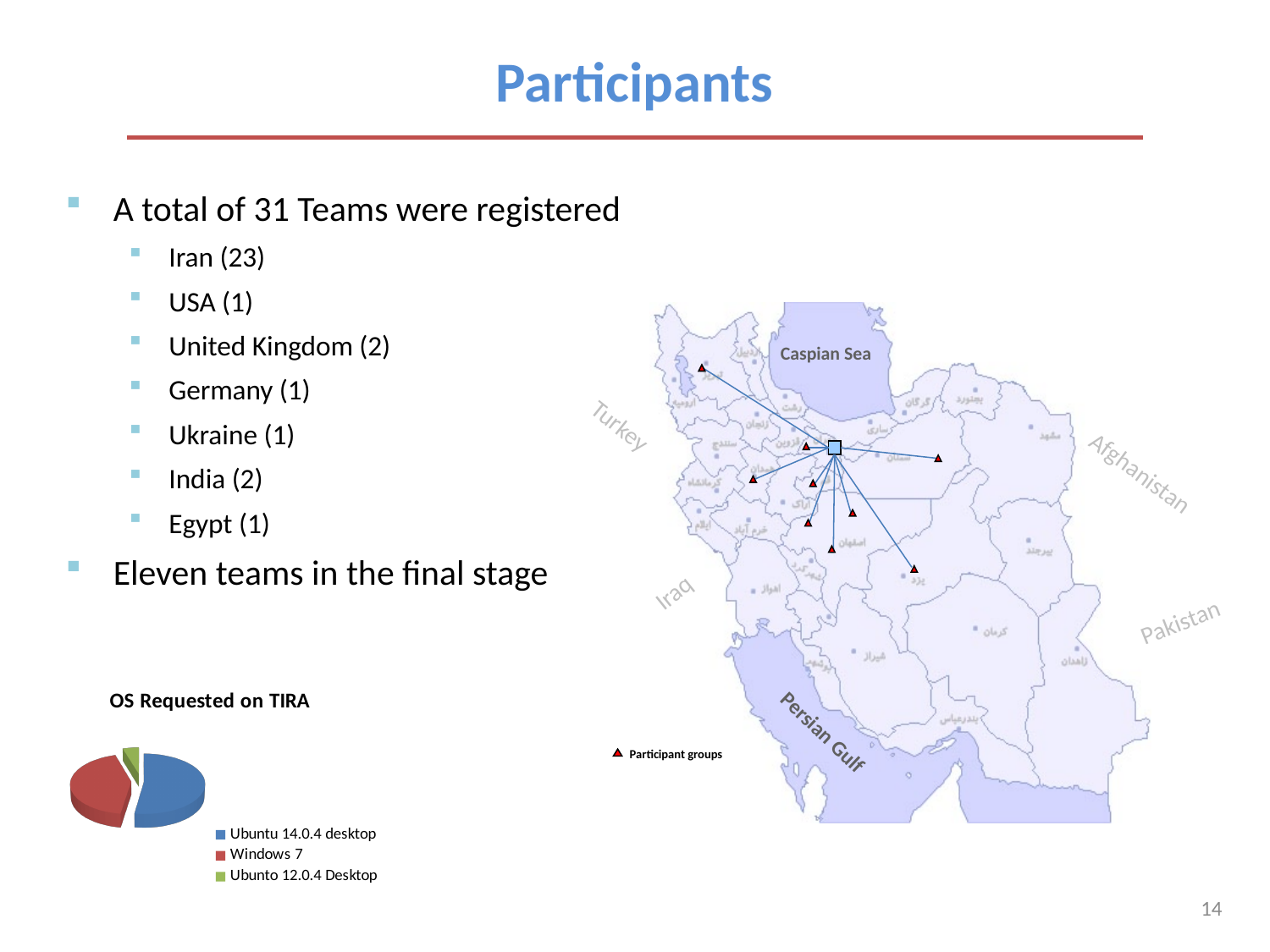
In the "OS Requested on TIRA" pie chart, which slice is larger: Ubuntu 14.0.4 desktop or Windows 7? Ubuntu 14.0.4 desktop How many slices does the "OS Requested on TIRA" pie chart have? 3 In the "OS Requested on TIRA" pie chart, which operating system has the largest slice? Ubuntu 14.0.4 desktop In the "OS Requested on TIRA" pie chart, which slice is larger: Windows 7 or Ubunto 12.0.4 Desktop? Windows 7 What is the title of the pie chart on the slide? OS Requested on TIRA How many entries does the legend of the "OS Requested on TIRA" chart list? 3 In the "OS Requested on TIRA" pie chart, what colour is the Windows 7 slice? red In the "OS Requested on TIRA" pie chart, which operating system has the smallest slice? Ubunto 12.0.4 Desktop What kind of chart is the "OS Requested on TIRA" chart? pie chart